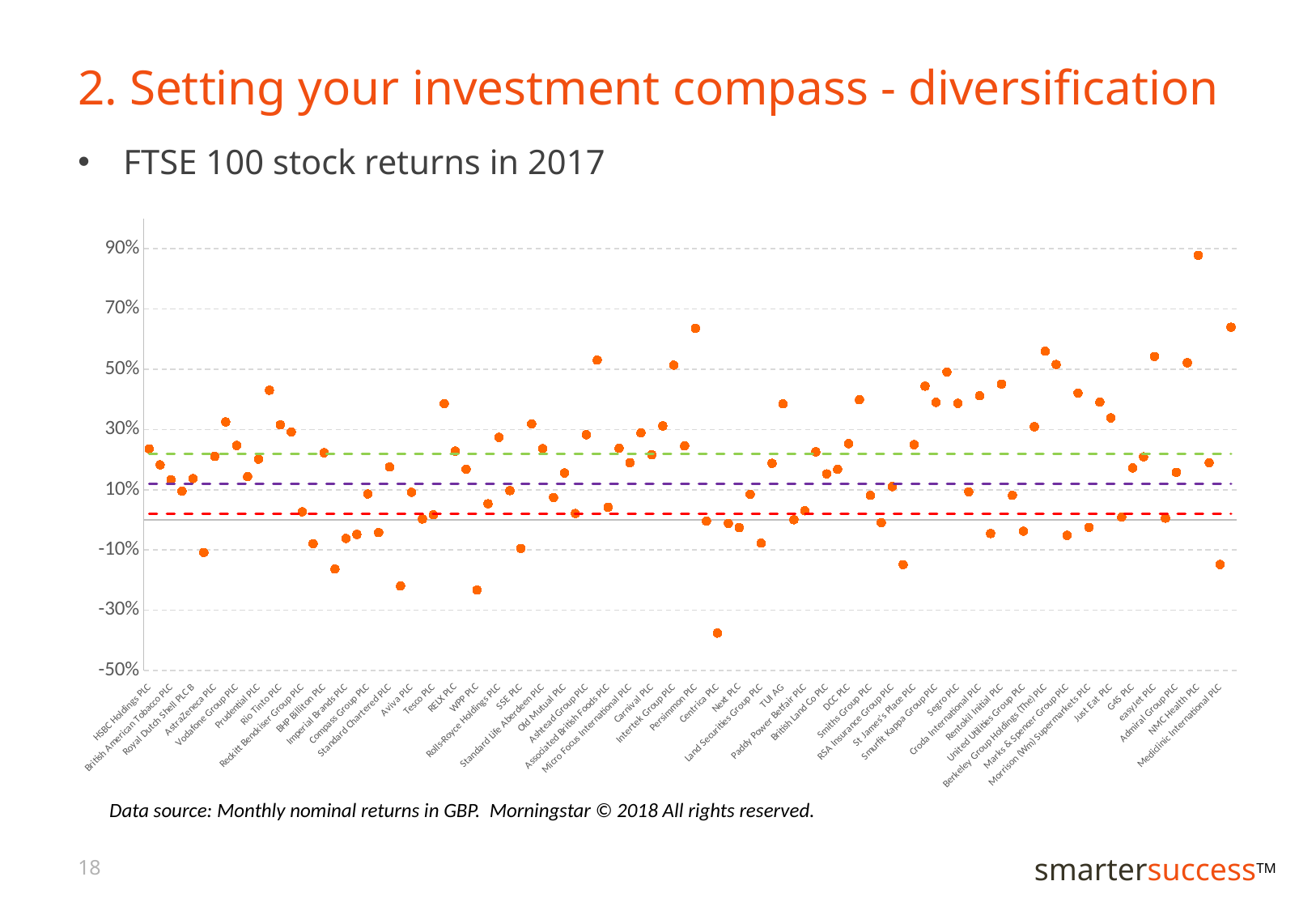
Is the red dashed horizontal line above or below the 10% gridline? below Is the value for HSBC Holdings PLC greater or less than 30%? less Is the green dashed horizontal line above or below the 30% gridline? below What is the highest value shown on the vertical axis? 90% What does the bullet point above the chart say the chart shows? FTSE 100 stock returns in 2017 What kind of chart is shown on the slide? scatter chart Which of the three dashed horizontal lines sits highest on the chart: green, purple or red? green